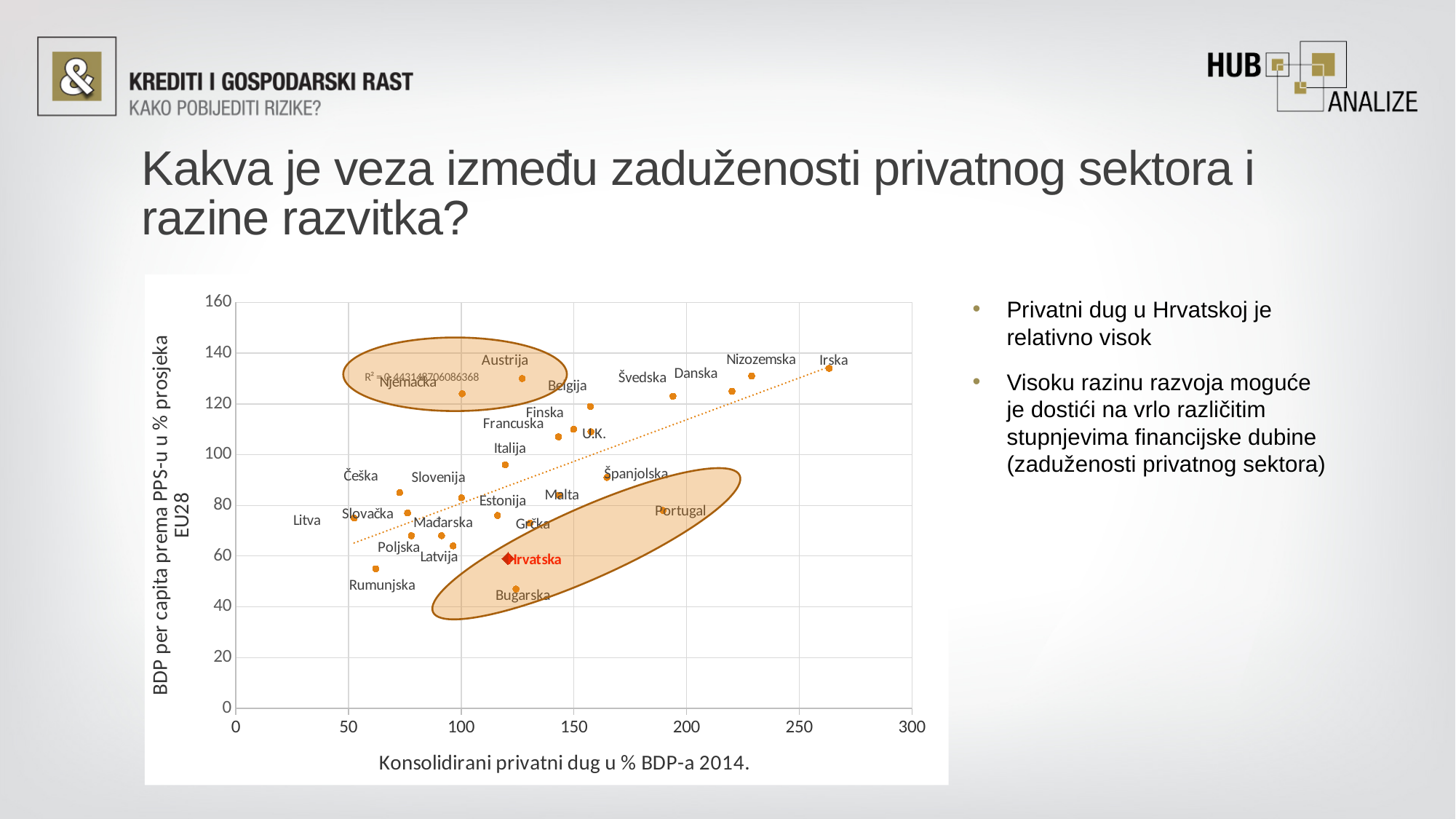
Is the GDP per capita value for Austrija greater or less than 120? greater What kind of chart is shown on the slide? scatter chart Is the private debt value (x axis) for Hrvatska greater or less than 100? greater Which has a higher GDP per capita value, Austrija or Bugarska? Austrija Which country has the highest consolidated private debt (x-axis value) on the chart? Irska Is the GDP per capita value for Hrvatska greater or less than 80? less Do the points generally rise or fall as private debt increases along the x axis? rise Which country is furthest to the left on the x axis (lowest private debt)? Litva What is the title of the x axis? Konsolidirani privatni dug u % BDP-a 2014. Which country has the lowest GDP per capita (y-axis value) on the chart? Bugarska